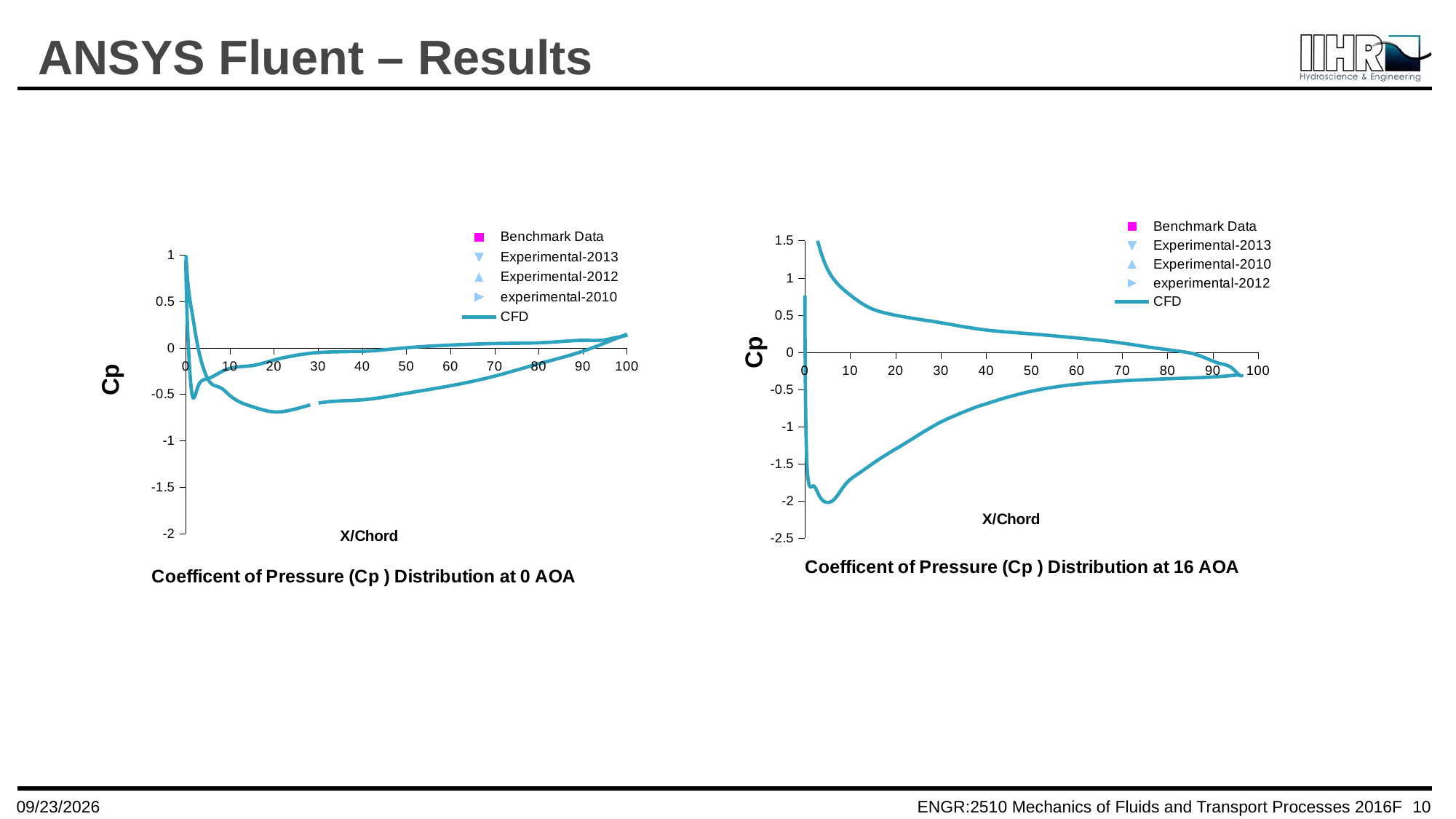
In the 'Coefficent of Pressure (Cp ) Distribution at 0 AOA' chart, is the lowest Cp value of the CFD curve greater or less than -0.5? less Which legend entry in the 'Coefficent of Pressure (Cp ) Distribution at 0 AOA' chart is drawn as a solid line rather than a marker? CFD What is the x-axis label of the 'Coefficent of Pressure (Cp ) Distribution at 16 AOA' chart? X/Chord What is the highest value shown on the x-axis of the 'Coefficent of Pressure (Cp ) Distribution at 0 AOA' chart? 100 In the 'Coefficent of Pressure (Cp ) Distribution at 0 AOA' chart, is the highest Cp value of the CFD curve greater or less than 0.5? greater In the 'Coefficent of Pressure (Cp ) Distribution at 16 AOA' chart, is the lowest Cp value of the CFD curve greater or less than -1.5? less What is the lowest value shown on the y-axis of the 'Coefficent of Pressure (Cp ) Distribution at 16 AOA' chart? -2.5 What kind of chart is the 'Coefficent of Pressure (Cp ) Distribution at 0 AOA' chart? Line chart What is the lowest value shown on the y-axis of the 'Coefficent of Pressure (Cp ) Distribution at 0 AOA' chart? -2 How many series does the legend of the 'Coefficent of Pressure (Cp ) Distribution at 16 AOA' chart list? 5 How many series does the legend of the 'Coefficent of Pressure (Cp ) Distribution at 0 AOA' chart list? 5